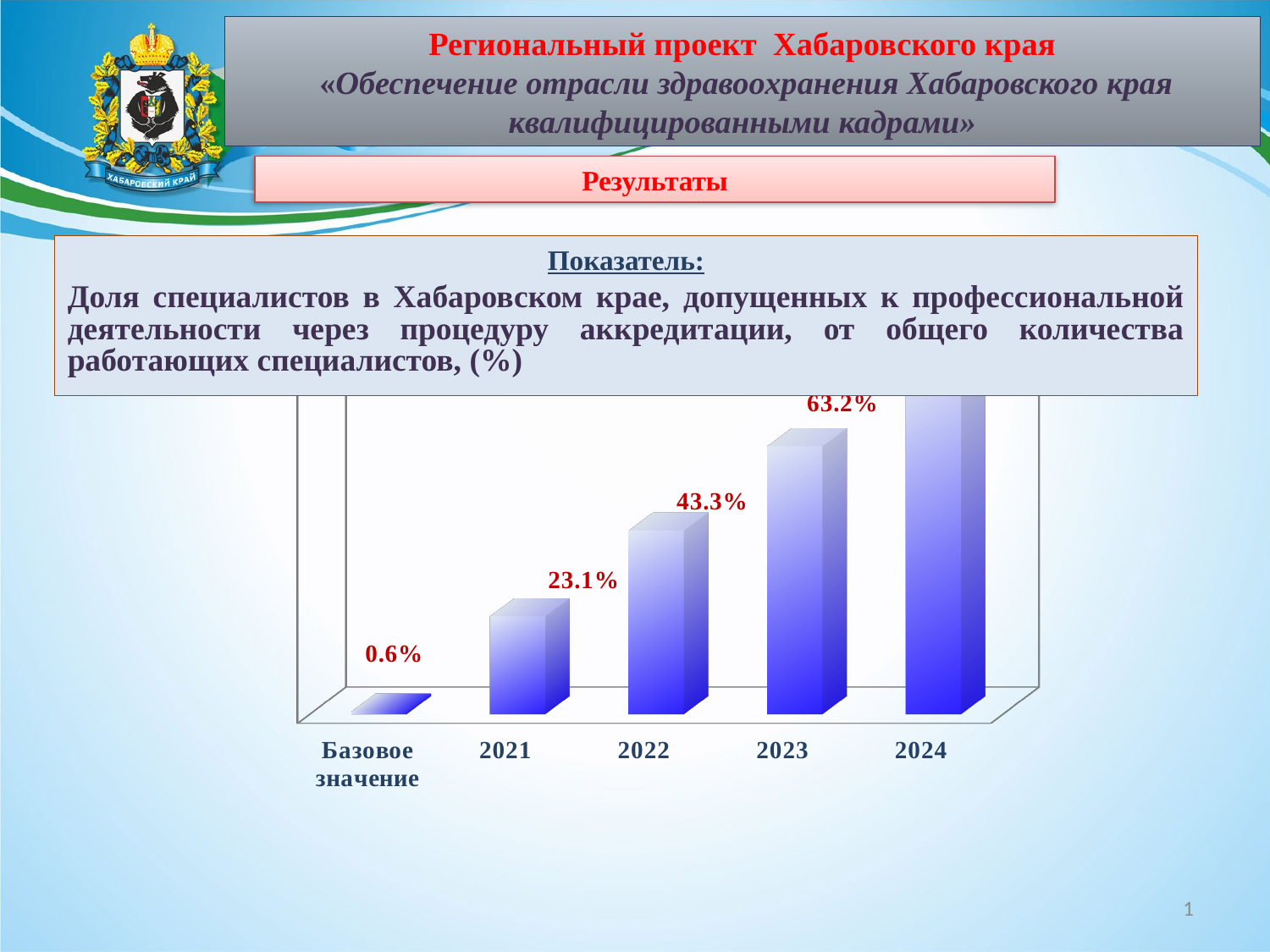
Which category has the lowest value? Базовое значение How many categories are shown on the x axis? 5 What kind of chart is shown on the slide? Bar chart By how much does the value for 2023 exceed the value for 2022? 19.9% Which is larger, the value for 2021 or the value for 2023? 2023 What value is shown for 2023? 63.2% By how much does the value for 2022 exceed the value for 2021? 20.2% Which category has the tallest bar? 2024 Do the values rise or fall from left to right along the x axis? Rise What value is shown for the category "Базовое значение"? 0.6% What value is shown for 2021? 23.1% What value is shown for 2022? 43.3%